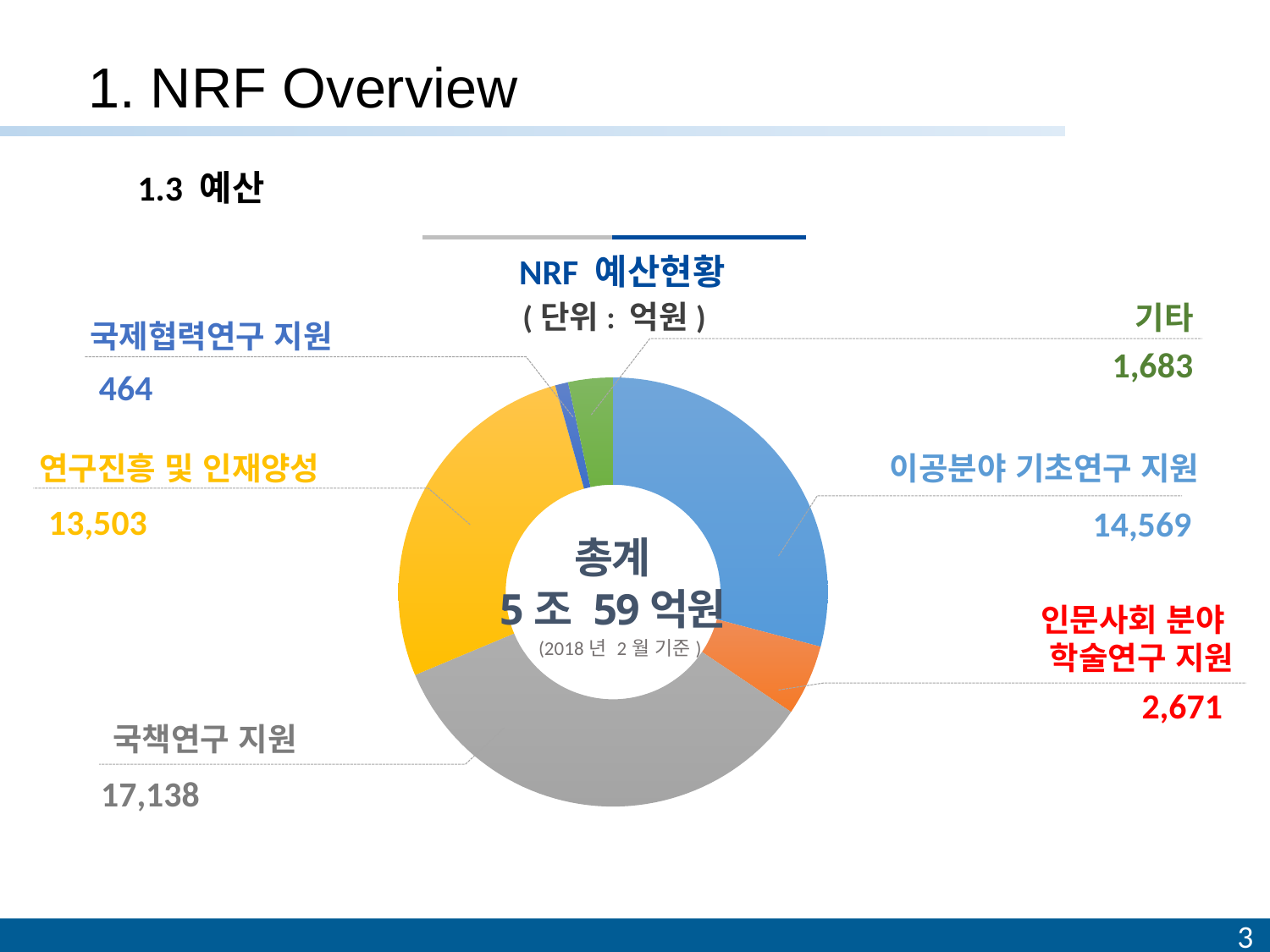
What is the value for 이공분야 기초연구 지원? 14,569 What unit is stated for the values in the chart? 억원 How many categories are shown in the chart? 6 What is the title of the chart? NRF 예산현황 What is the value for 국책연구 지원? 17,138 What is the value for 국제협력연구 지원? 464 Which is larger, 연구진흥 및 인재양성 or 이공분야 기초연구 지원? 이공분야 기초연구 지원 What is the value for 인문사회 분야 학술연구 지원? 2,671 What type of chart is shown on the slide? Doughnut (pie) chart What is the difference between 국책연구 지원 and 이공분야 기초연구 지원? 2,569 Which category has the largest value? 국책연구 지원 Which category has the smallest value? 국제협력연구 지원